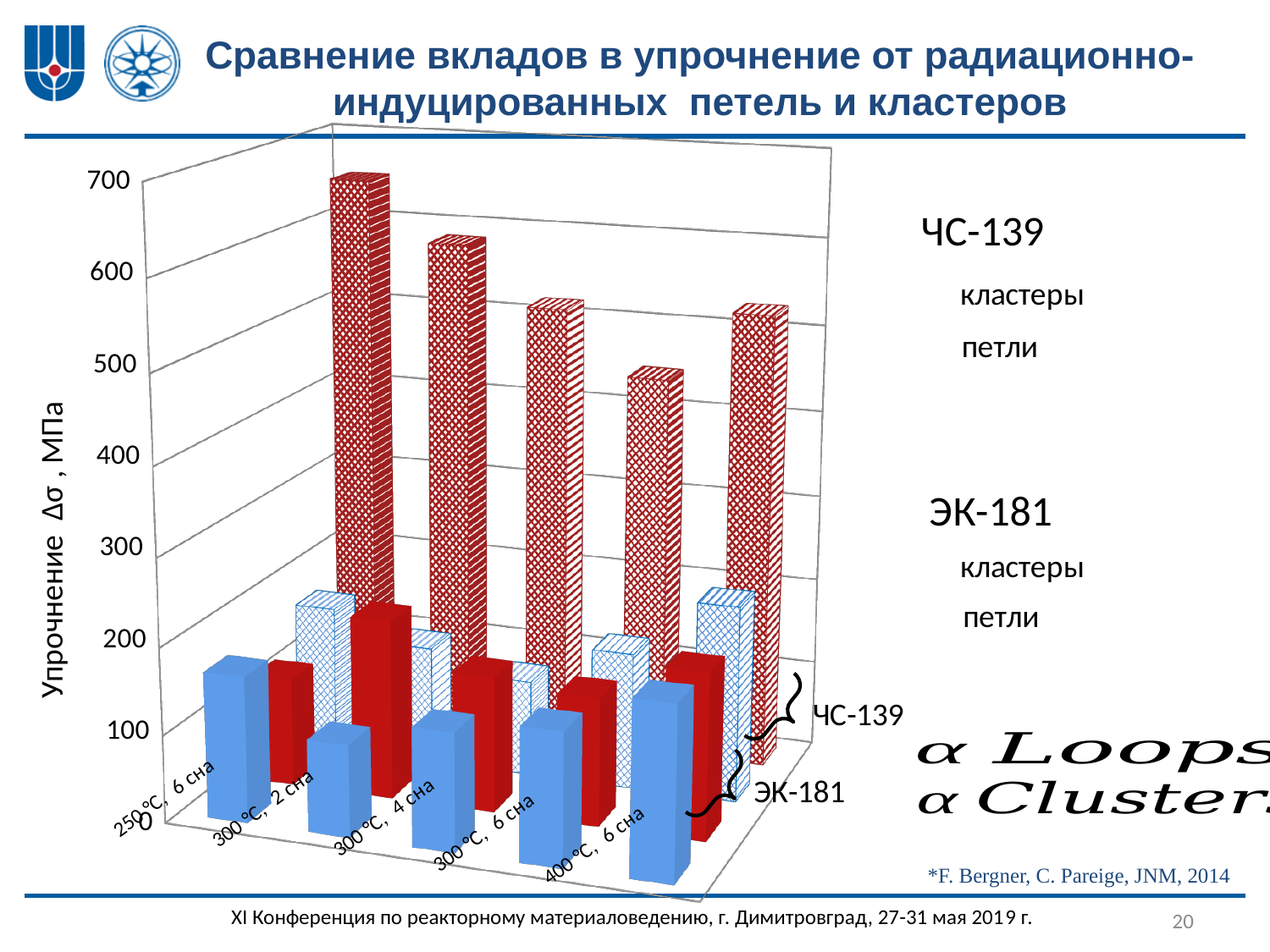
What kind of chart is shown on the slide? bar chart What is the title of the vertical axis of the chart? Упрочнение Δσ, МПа How many series does the chart's legend list? 4 Which two steels are compared in the chart's legend? ЧС-139 and ЭК-181 How many irradiation conditions (categories) are shown along the x axis of the chart? 5 Is the ЭК-181 кластеры value at 300°C, 2 сна greater or less than 300? less Do the ЧС-139 петли values rise or fall from 250°C, 6 сна through 300°C, 6 сна? fall